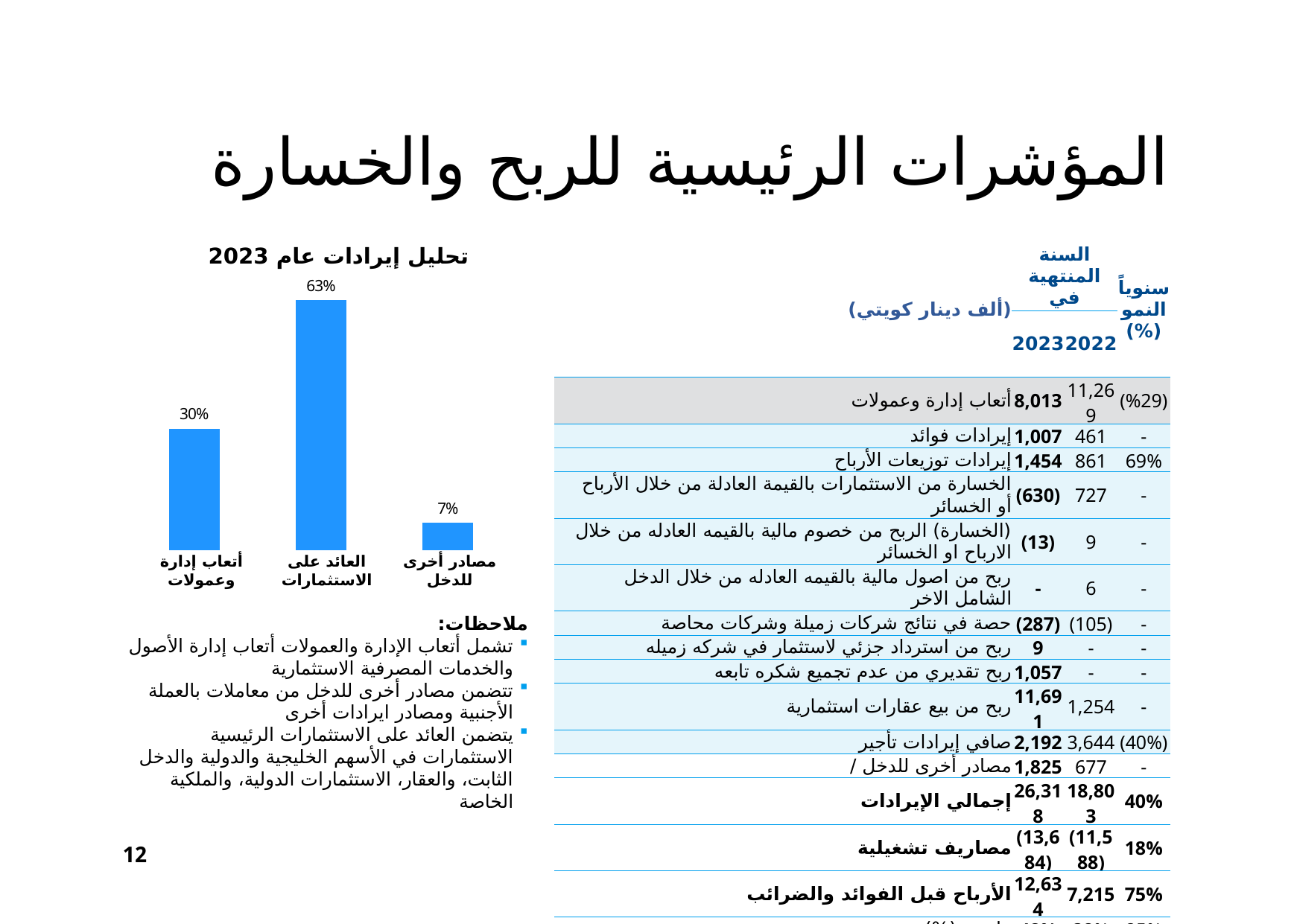
What kind of chart is تحليل إيرادات عام 2023? bar chart How many categories are shown in the chart تحليل إيرادات عام 2023? 3 What colour are the bars in the chart تحليل إيرادات عام 2023? blue What is the value for العائد على الاستثمارات in the chart تحليل إيرادات عام 2023? 63% What is the difference between the values for أتعاب إدارة وعمولات and مصادر أخرى للدخل in the chart تحليل إيرادات عام 2023? 23% What is the difference between the values for العائد على الاستثمارات and أتعاب إدارة وعمولات in the chart تحليل إيرادات عام 2023? 33% What is the value for أتعاب إدارة وعمولات in the chart تحليل إيرادات عام 2023? 30% Which category has the lowest value in the chart تحليل إيرادات عام 2023? مصادر أخرى للدخل Which is larger in the chart تحليل إيرادات عام 2023: أتعاب إدارة وعمولات or مصادر أخرى للدخل? أتعاب إدارة وعمولات What is the value for مصادر أخرى للدخل in the chart تحليل إيرادات عام 2023? 7% Which category has the highest value in the chart تحليل إيرادات عام 2023? العائد على الاستثمارات What is the title of the chart on the slide? تحليل إيرادات عام 2023